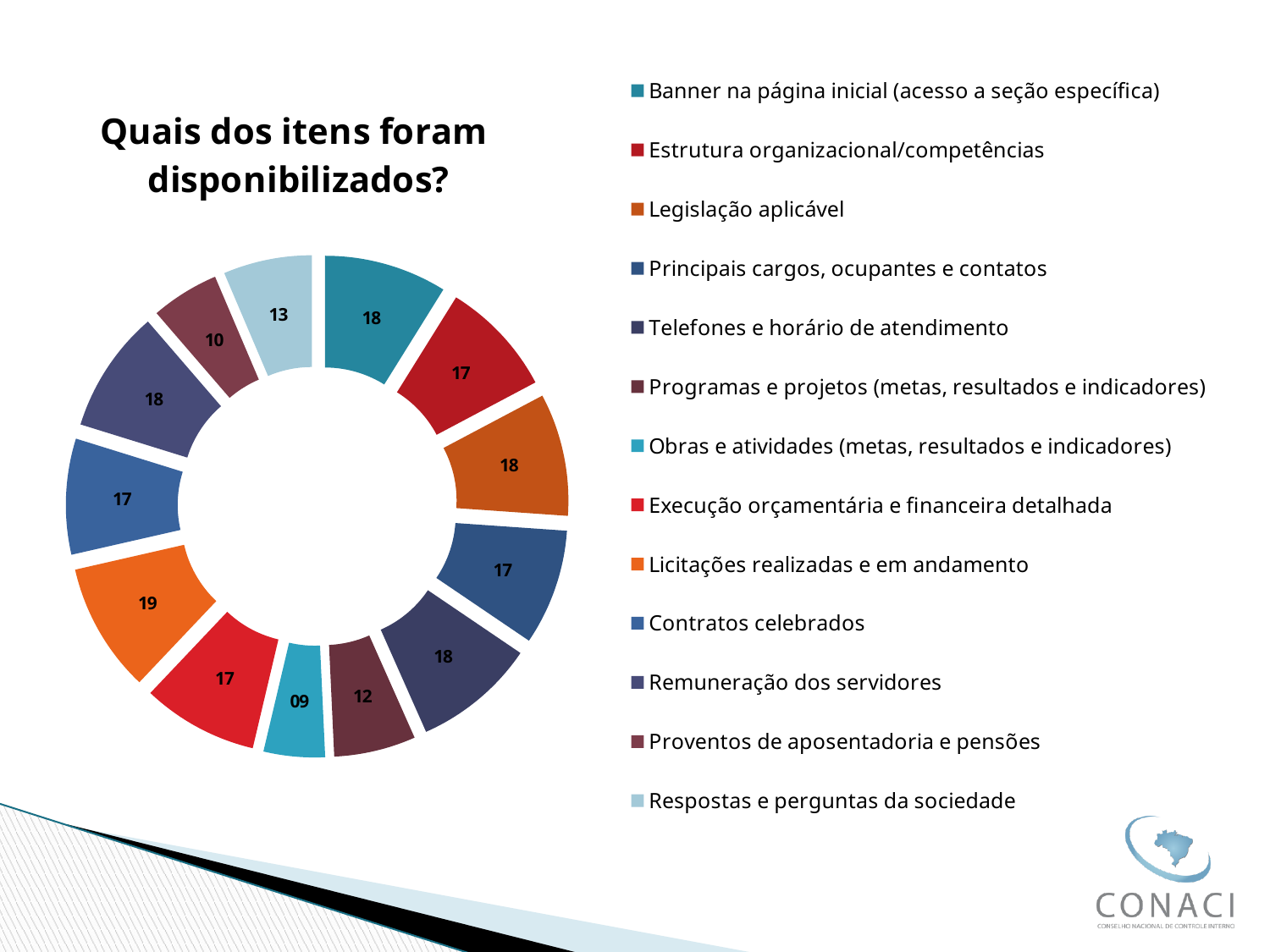
Which item has the highest value? Licitações realizadas e em andamento What is the title of the chart? Quais dos itens foram disponibilizados? Which is larger: the value for Respostas e perguntas da sociedade or the value for Proventos de aposentadoria e pensões? Respostas e perguntas da sociedade What is the value for Obras e atividades (metas, resultados e indicadores)? 09 What is the difference between the values for Licitações realizadas e em andamento and Obras e atividades (metas, resultados e indicadores)? 10 How many slices does the chart have? 13 What is the value for Respostas e perguntas da sociedade? 13 What kind of chart is shown on the slide? Doughnut chart What is the value for Programas e projetos (metas, resultados e indicadores)? 12 What is the value for Licitações realizadas e em andamento? 19 Which item has the lowest value? Obras e atividades (metas, resultados e indicadores) What is the value for Proventos de aposentadoria e pensões? 10